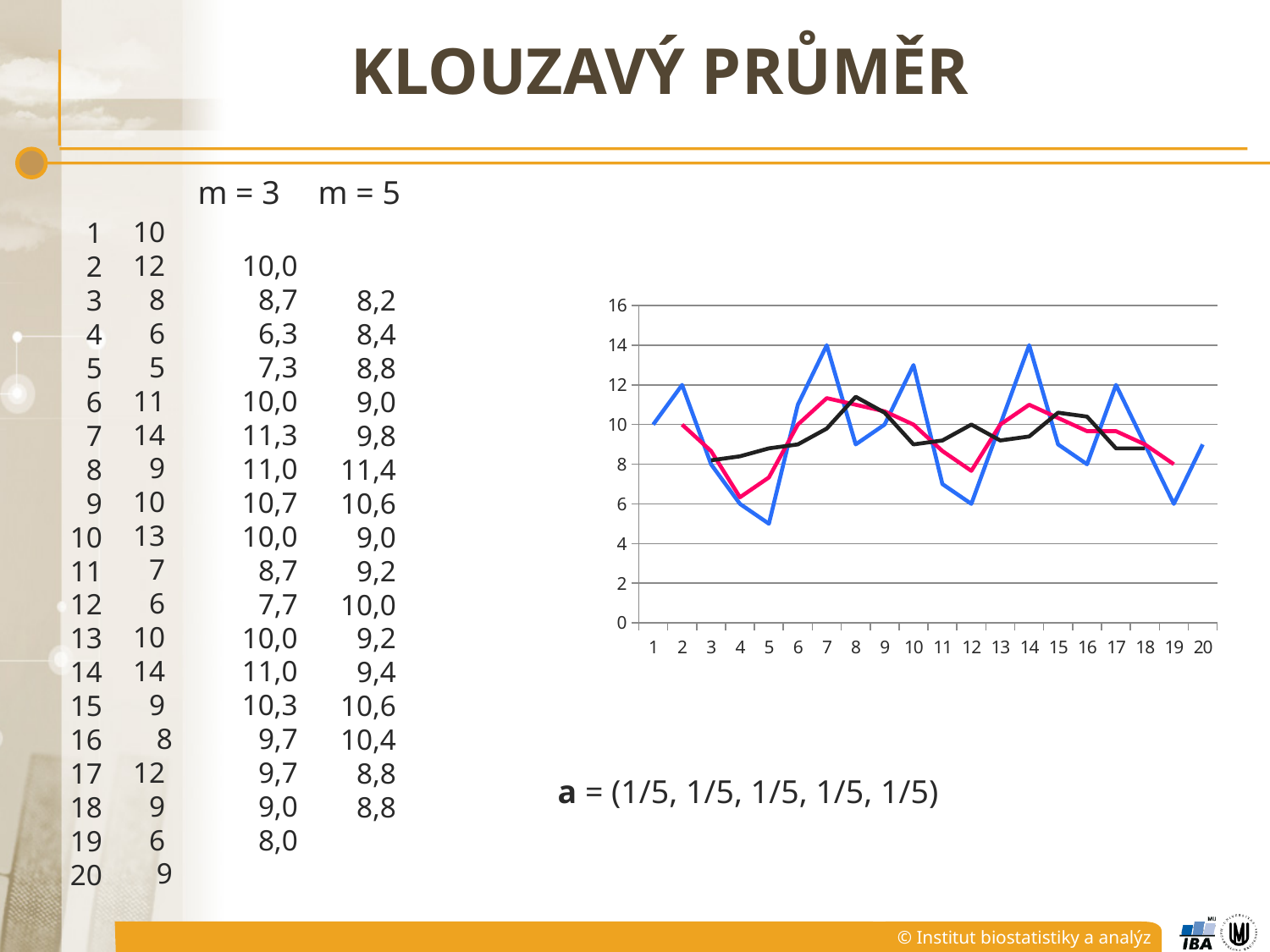
Does the blue line rise or fall from x = 14 to x = 16? fall How many points are labelled along the x axis of the chart? 20 What is the value of the blue line at x = 7? 14 What kind of chart is shown on the slide? line chart What is the value of the blue line at x = 1? 10 Is the value of the red line at x = 7 greater or less than 10? greater What is the value of the blue line at x = 12? 6 Which is larger: the blue line's value at x = 7 or at x = 5? x = 7 How many lines are plotted on the chart? 3 At which x value does the blue line reach its lowest point? 5 Is the value of the blue line at x = 5 greater or less than 6? less Is the value of the blue line at x = 10 greater or less than 12? greater